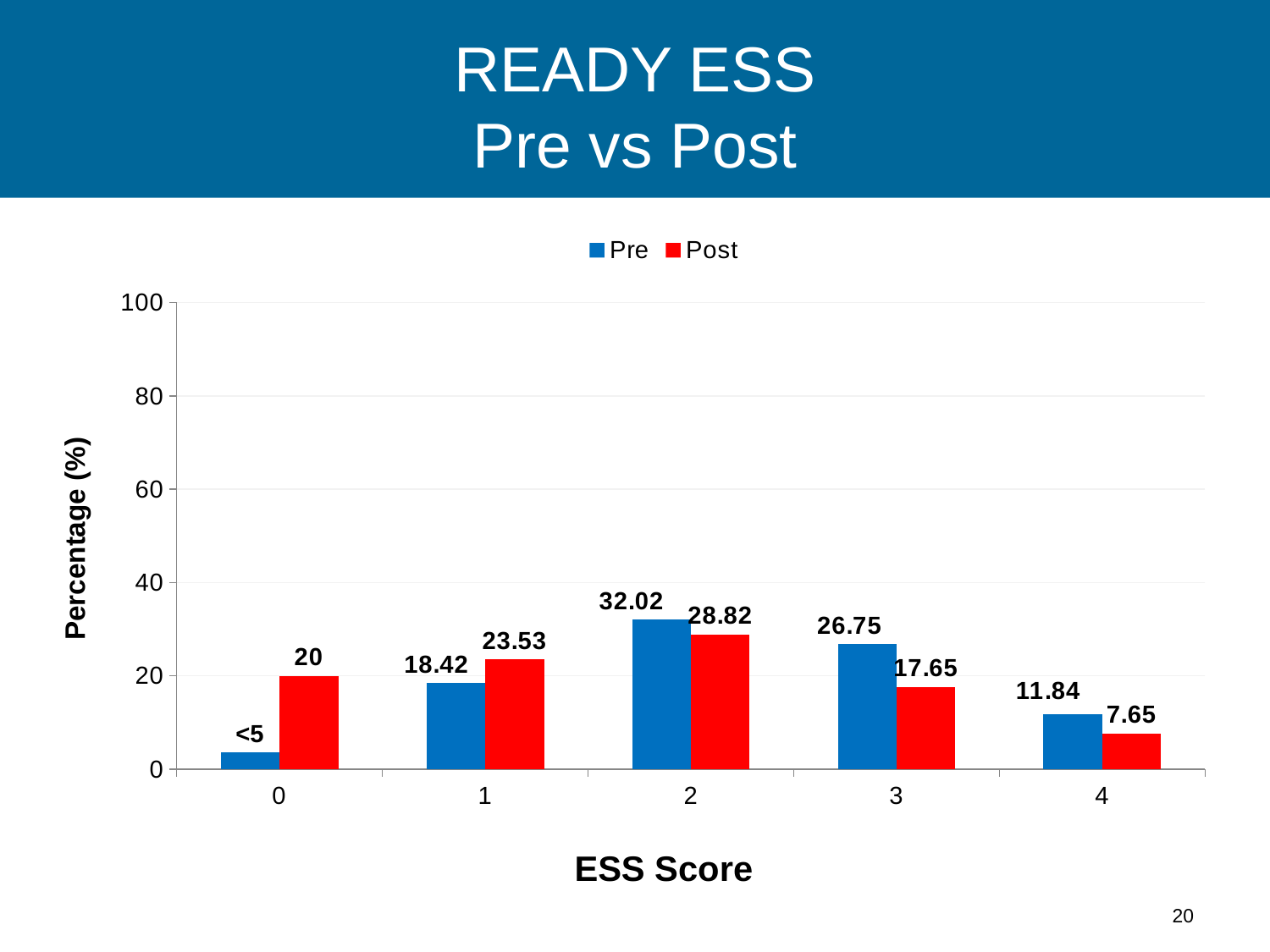
What is the Post value for ESS Score 0? 20 What is the Pre value for ESS Score 4? 11.84 What kind of chart is shown on the slide? bar chart What is the Pre value for ESS Score 3? 26.75 How many series does the legend list? 2 What is the Post value for ESS Score 2? 28.82 What is the difference between the Pre and Post values for ESS Score 3? 9.1 Which ESS Score has the lowest Post value? 4 How many ESS Score categories are shown on the x axis? 5 For ESS Score 1, which is larger, the Pre value or the Post value? Post Which ESS Score has the highest Pre value? 2 Is the Pre value for ESS Score 0 greater or less than 20? less